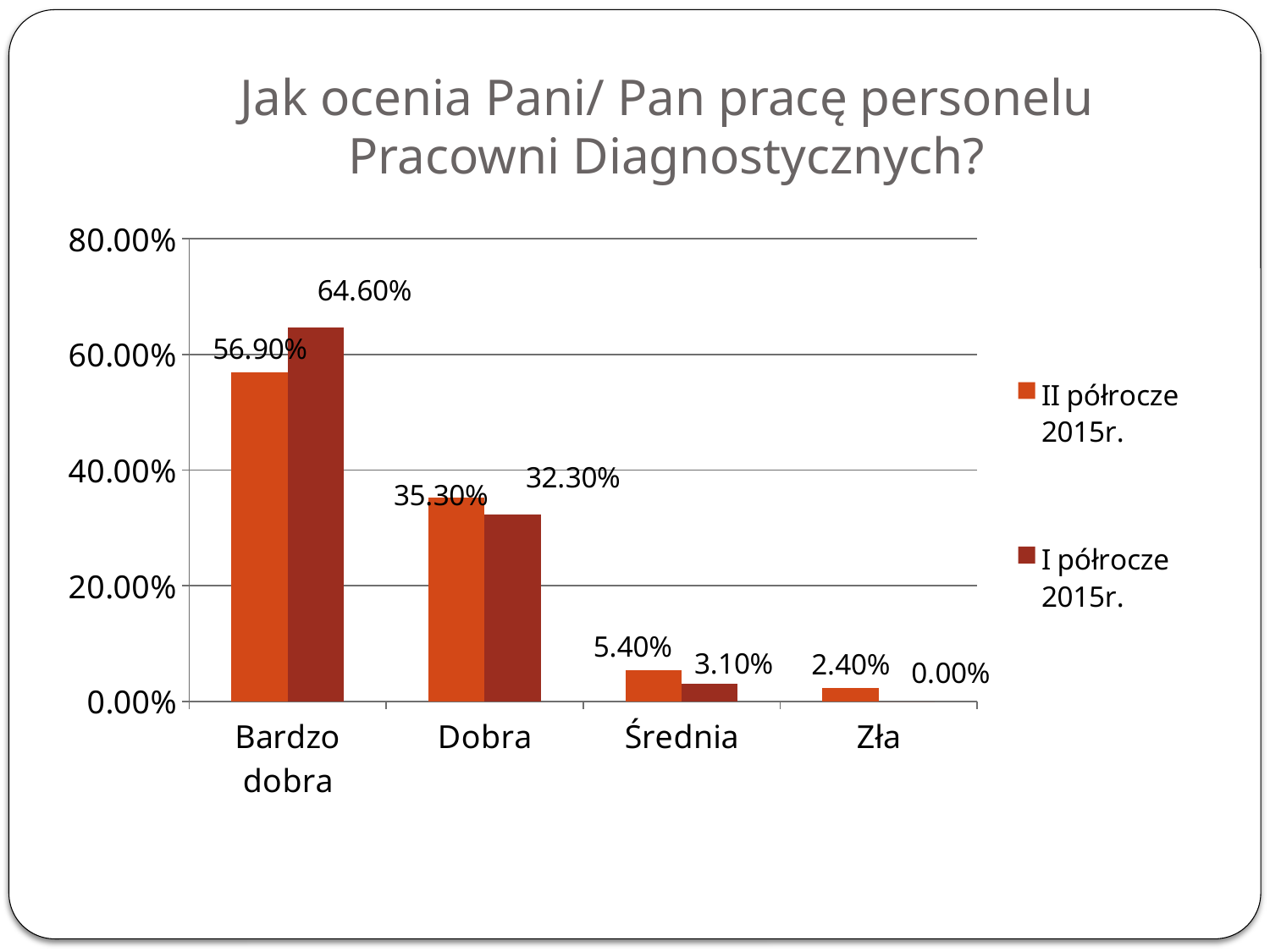
For "Dobra", which series has the larger value: II półrocze 2015r. or I półrocze 2015r.? II półrocze 2015r. Do the values in the II półrocze 2015r. series rise or fall from left to right along the x axis? Fall What is the value for "Bardzo dobra" in the I półrocze 2015r. series? 64.60% What is the value for "Dobra" in the II półrocze 2015r. series? 35.30% What kind of chart is shown on the slide? Bar chart How many categories are shown on the x axis? 4 How many series does the legend list? 2 Which category has the lowest value in the II półrocze 2015r. series? Zła What is the value for "Bardzo dobra" in the II półrocze 2015r. series? 56.90% Which category has the highest value in the I półrocze 2015r. series? Bardzo dobra What is the difference between the I półrocze 2015r. and II półrocze 2015r. values for "Bardzo dobra"? 7.70% What is the value for "Zła" in the I półrocze 2015r. series? 0.00%